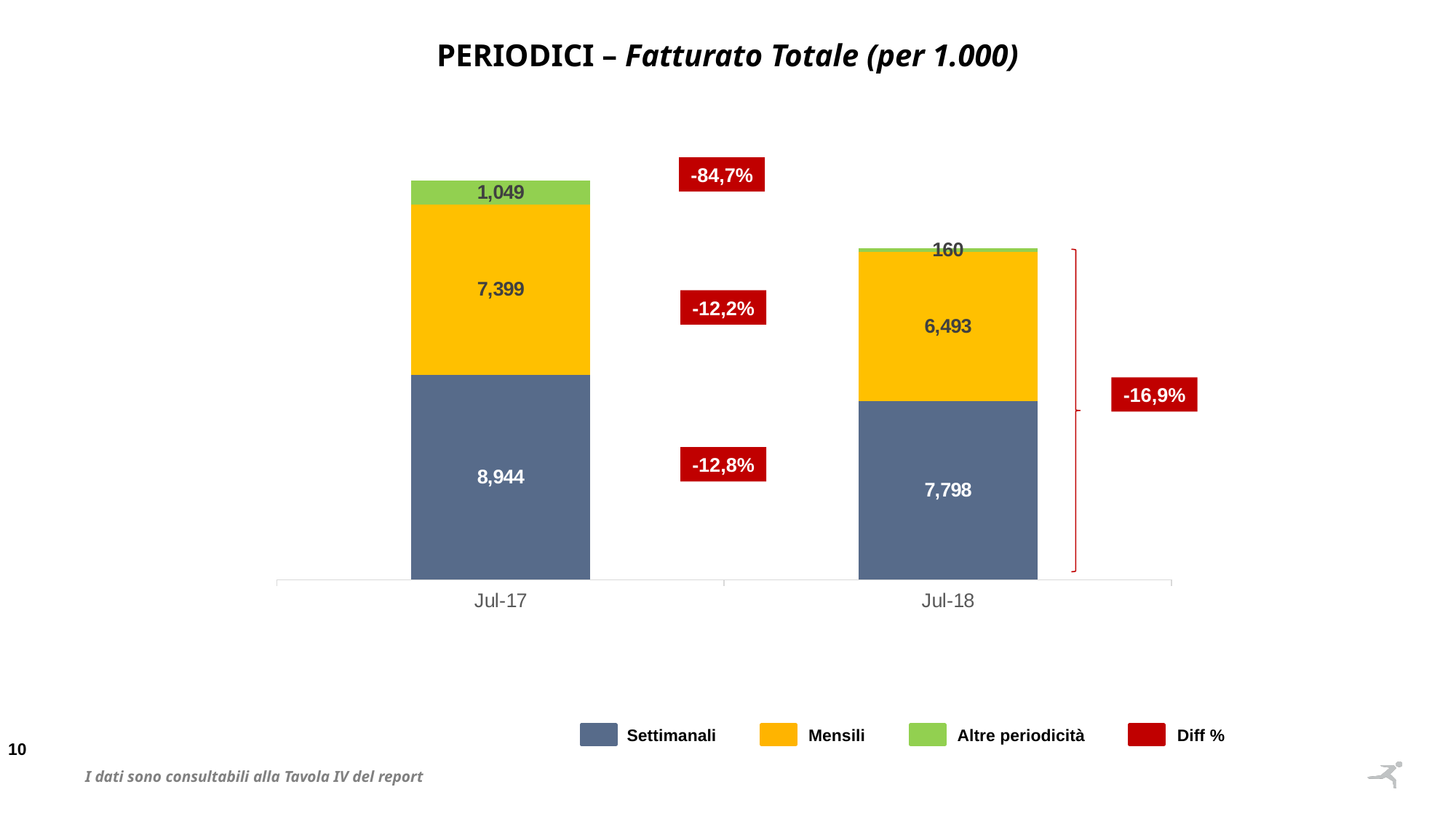
What is the Settimanali value for Jul-17? 8,944 What is the total of the stacked bar for Jul-17? 17,392 What kind of chart is shown on the slide? Stacked bar chart What is the total of the stacked bar for Jul-18? 14,451 Which is larger, the Mensili value for Jul-17 or for Jul-18? Jul-17 How many categories are shown on the x axis? 2 How many series does the legend list? 4 What is the Diff % shown for Altre periodicità? -84,7% What is the overall Diff % shown for the total between Jul-17 and Jul-18? -16,9% What is the Mensili value for Jul-18? 6,493 What is the difference between the Settimanali values for Jul-17 and Jul-18? 1,146 What is the Altre periodicità value for Jul-18? 160